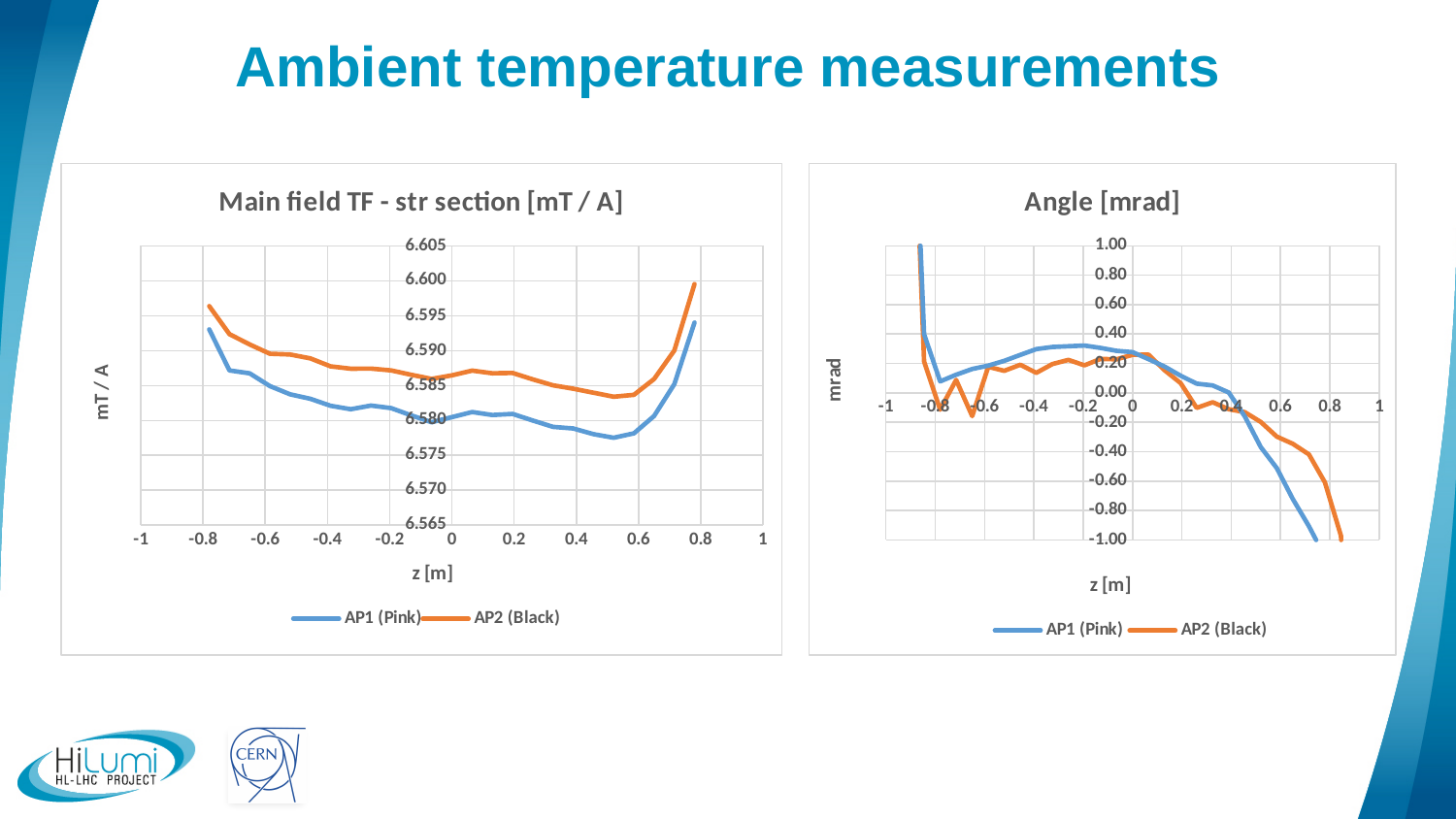
In the "Angle [mrad]" chart, do the values of AP1 (Pink) rise or fall between z = 0.2 and z = 0.8? fall How many series does the legend of the "Angle [mrad]" chart list? 2 What kind of chart is the chart titled "Main field TF - str section [mT / A]"? line chart In the "Angle [mrad]" chart, is the AP1 (Pink) value at z = -0.2 greater or less than 0.20? greater In the "Angle [mrad]" chart, which series has the higher value at z = 0.6, AP1 (Pink) or AP2 (Black)? AP2 (Black) In the "Main field TF - str section [mT / A]" chart, what are the two series named in the legend? AP1 (Pink) and AP2 (Black) What is the label of the x axis on the "Angle [mrad]" chart? z [m] In the "Main field TF - str section [mT / A]" chart, does the AP1 (Pink) series rise or fall between z = 0.6 and z = 0.8? rise In the "Angle [mrad]" chart, is the AP1 (Pink) value at z = 0.6 greater or less than -0.40? less In the "Main field TF - str section [mT / A]" chart, is the AP1 (Pink) value at z = 0 greater or less than 6.585? less In the "Main field TF - str section [mT / A]" chart, which series has the higher value at z = 0.2, AP1 (Pink) or AP2 (Black)? AP2 (Black)